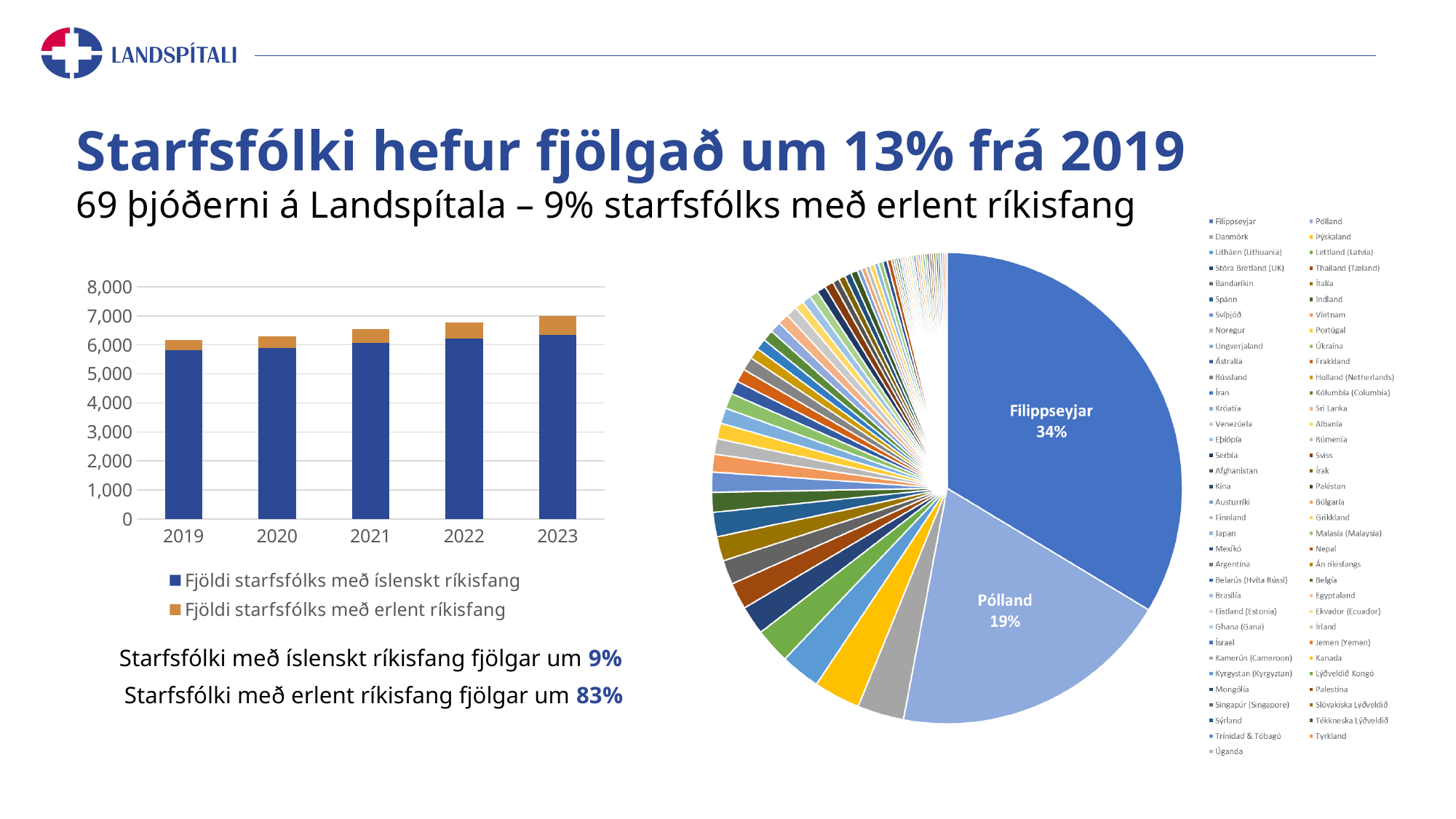
What kind of chart is the chart on the left side of the slide? bar chart In the pie chart on the right, what share of the pie does Filippseyjar have? 34% In the bar chart on the left, is the total stacked value for 2019 greater or less than 7,000? less In the bar chart on the left, which year has the highest total stacked bar? 2023 In the bar chart on the left, how many series does the legend list? 2 In the bar chart on the left, how many years are shown on the x axis? 5 In the pie chart on the right, what share of the pie does Pólland have? 19% What kind of chart is the chart on the right side of the slide? pie chart In the pie chart on the right, what is the difference in percentage points between the Filippseyjar and Pólland slices? 15 In the bar chart on the left, is the total stacked value for 2023 greater or less than 6,000? greater In the bar chart on the left, do the total bar heights rise or fall from 2019 to 2023? rise In the bar chart on the left, is the value for 'Fjöldi starfsfólks með íslenskt ríkisfang' in 2019 greater or less than 6,000? less